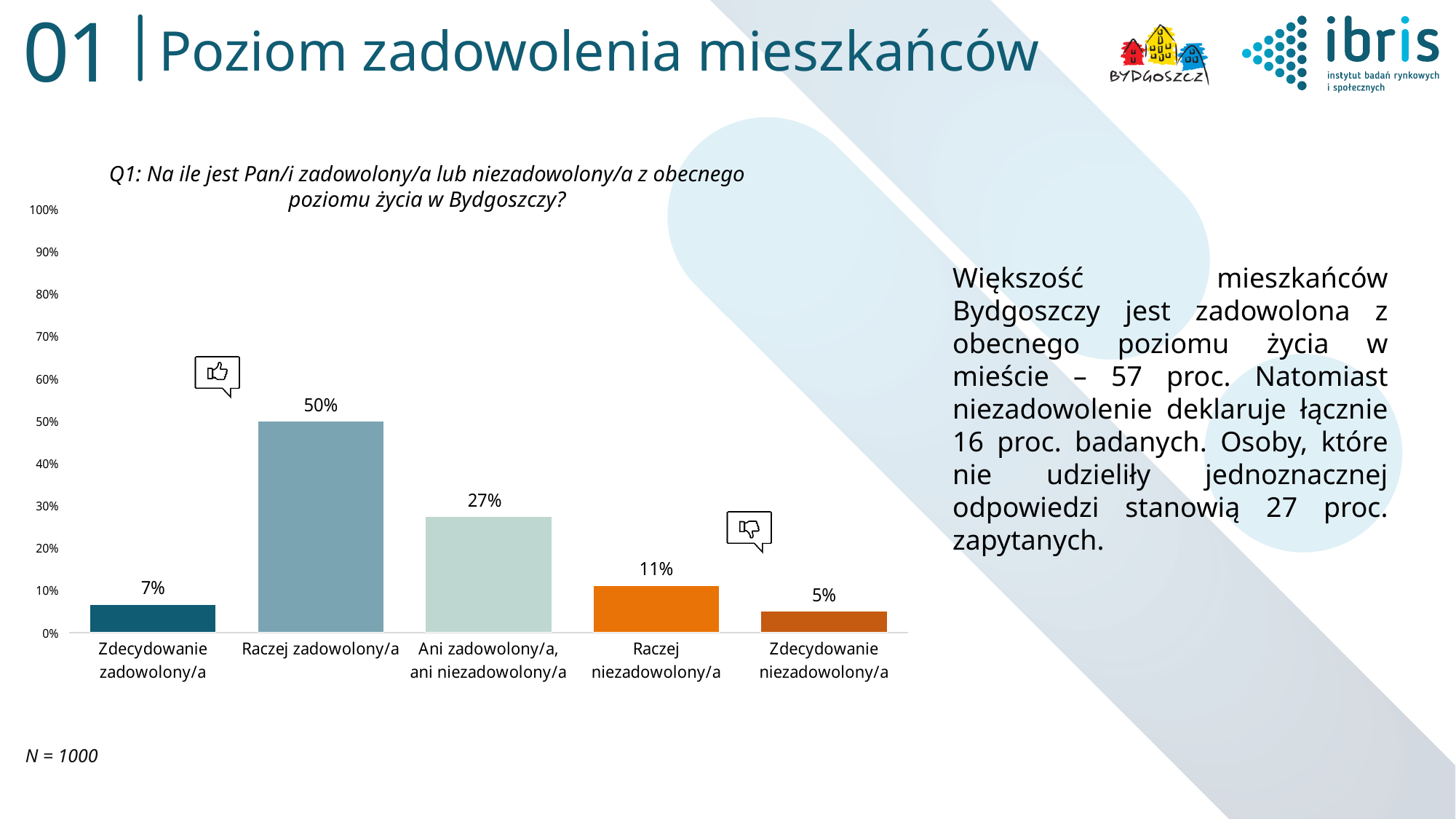
How many categories are shown on the chart? 5 Which category has the lowest value? Zdecydowanie niezadowolony/a What kind of chart is shown on the slide? Bar chart Which is larger: the value for "Raczej niezadowolony/a" or "Zdecydowanie zadowolony/a"? Raczej niezadowolony/a What is the value for "Raczej niezadowolony/a"? 11% What is the difference between the values for "Raczej zadowolony/a" and "Ani zadowolony/a, ani niezadowolony/a"? 23% What sample size (N) is stated below the chart? N = 1000 What is the value for "Zdecydowanie niezadowolony/a"? 5% What is the value for "Zdecydowanie zadowolony/a"? 7% Which category has the highest value? Raczej zadowolony/a What is the value for "Ani zadowolony/a, ani niezadowolony/a"? 27% What is the value for "Raczej zadowolony/a"? 50%